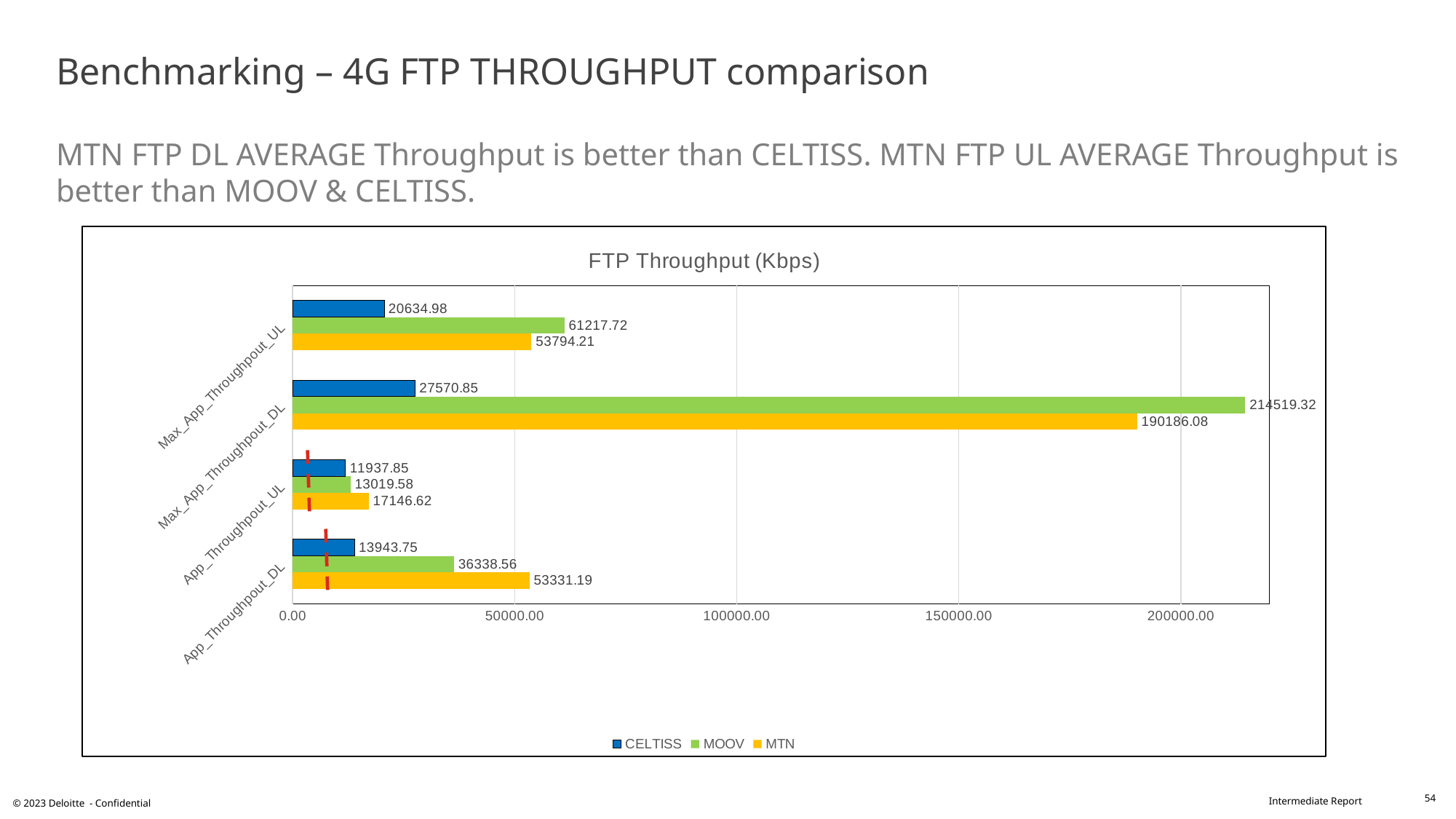
What is the CELTISS value for Max_App_Throughpout_UL? 20634.98 For Max_App_Throughpout_UL, which is larger: the MOOV value or the MTN value? MOOV What is the title of the chart? FTP Throughput (Kbps) Which operator has the lowest value for Max_App_Throughpout_DL? CELTISS What type of chart is shown on the slide? Bar chart What is the MTN value for App_Throughpout_UL? 17146.62 Which operator has the highest value for App_Throughpout_DL? MTN What is the difference between the MTN and CELTISS values for App_Throughpout_DL? 39387.44 How many categories are shown on the vertical axis of the chart? 4 How many series does the legend list? 3 What is the MOOV value for Max_App_Throughpout_DL? 214519.32 What is the difference between the MOOV and MTN values for Max_App_Throughpout_DL? 24333.24